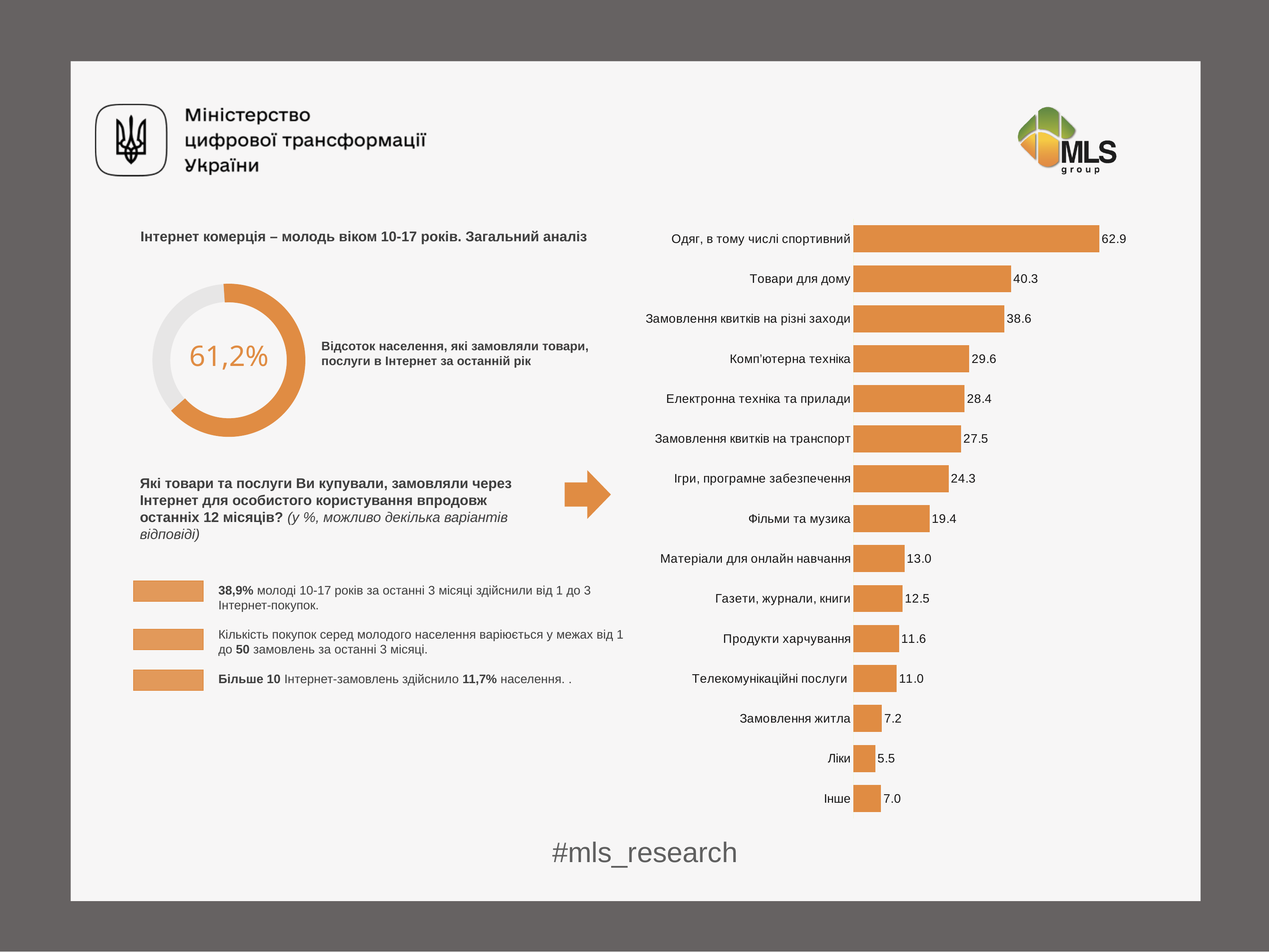
In the bar chart on the right, what is the value for Фільми та музика? 19.4 In the bar chart on the right, what is the difference between the values for Комп’ютерна техніка and Електронна техніка та прилади? 1.2 In the bar chart on the right, how many categories are shown? 15 In the bar chart on the right, what is the difference between the values for Товари для дому and Замовлення квитків на різні заходи? 1.7 In the bar chart on the right, what is the value for Товари для дому? 40.3 In the donut chart on the left, what percentage is shown in the centre? 61,2% In the bar chart on the right, what is the value for Одяг, в тому числі спортивний? 62.9 What kind of chart is shown on the right side of the slide? Bar chart In the bar chart on the right, what is the value for Ліки? 5.5 In the bar chart on the right, which category has the highest value? Одяг, в тому числі спортивний In the bar chart on the right, which is larger: Замовлення житла or Інше? Замовлення житла In the bar chart on the right, which category has the lowest value? Ліки